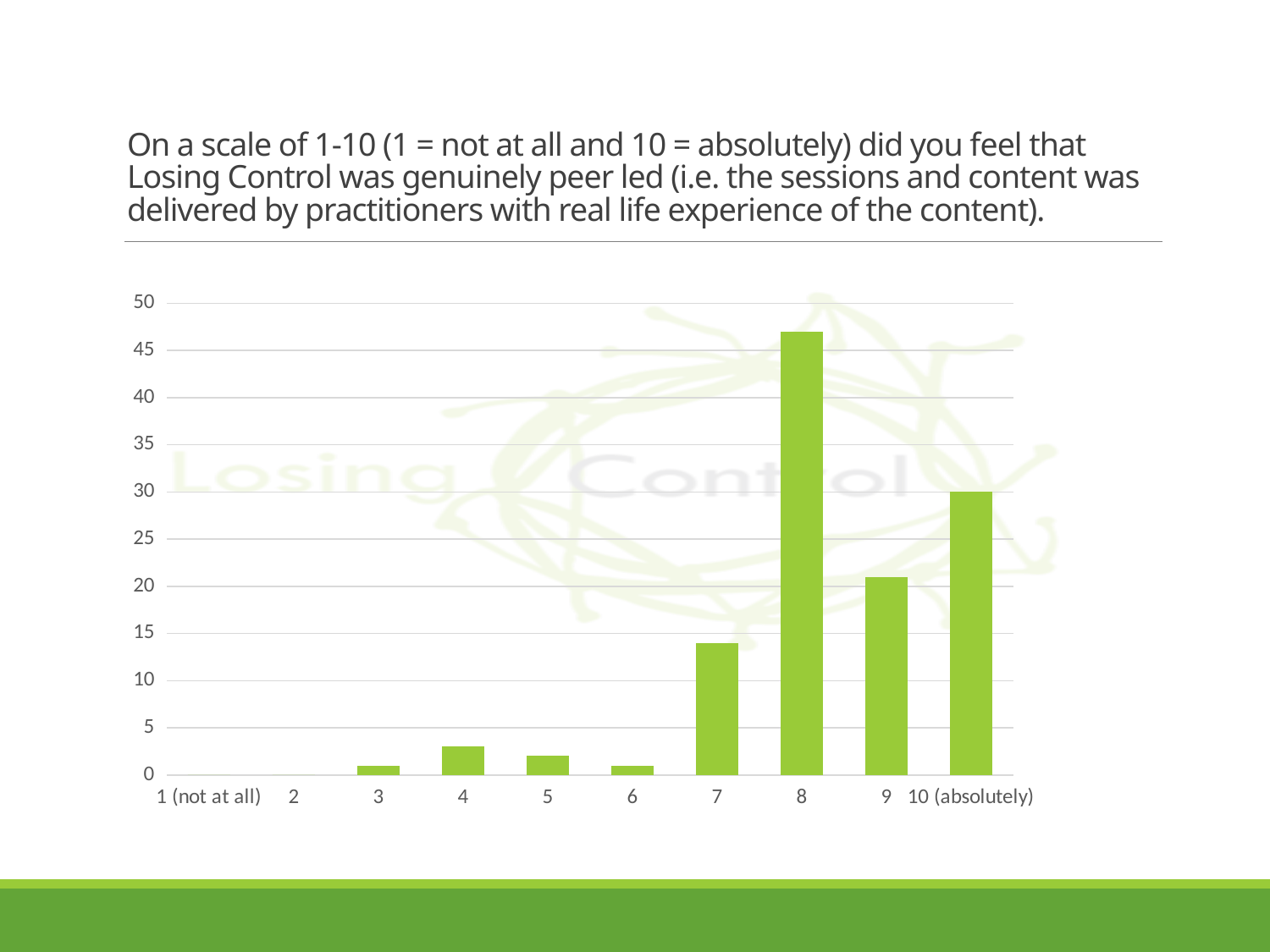
How many rating categories are shown on the x axis? 10 Which is larger, the value for rating 9 or the value for rating 7? 9 Is the value for rating 9 greater or less than 20? greater Do the values generally rise or fall from rating 3 to rating 8? rise What is the value for the 10 (absolutely) category? 30 Is the value for rating 8 greater or less than 45? greater Is the value for rating 4 greater or less than 5? less Which rating category has the highest bar? 8 Which is larger, the value for rating 8 or the value for 10 (absolutely)? 8 What colour are the bars in the chart? green What kind of chart is shown on the slide? bar chart